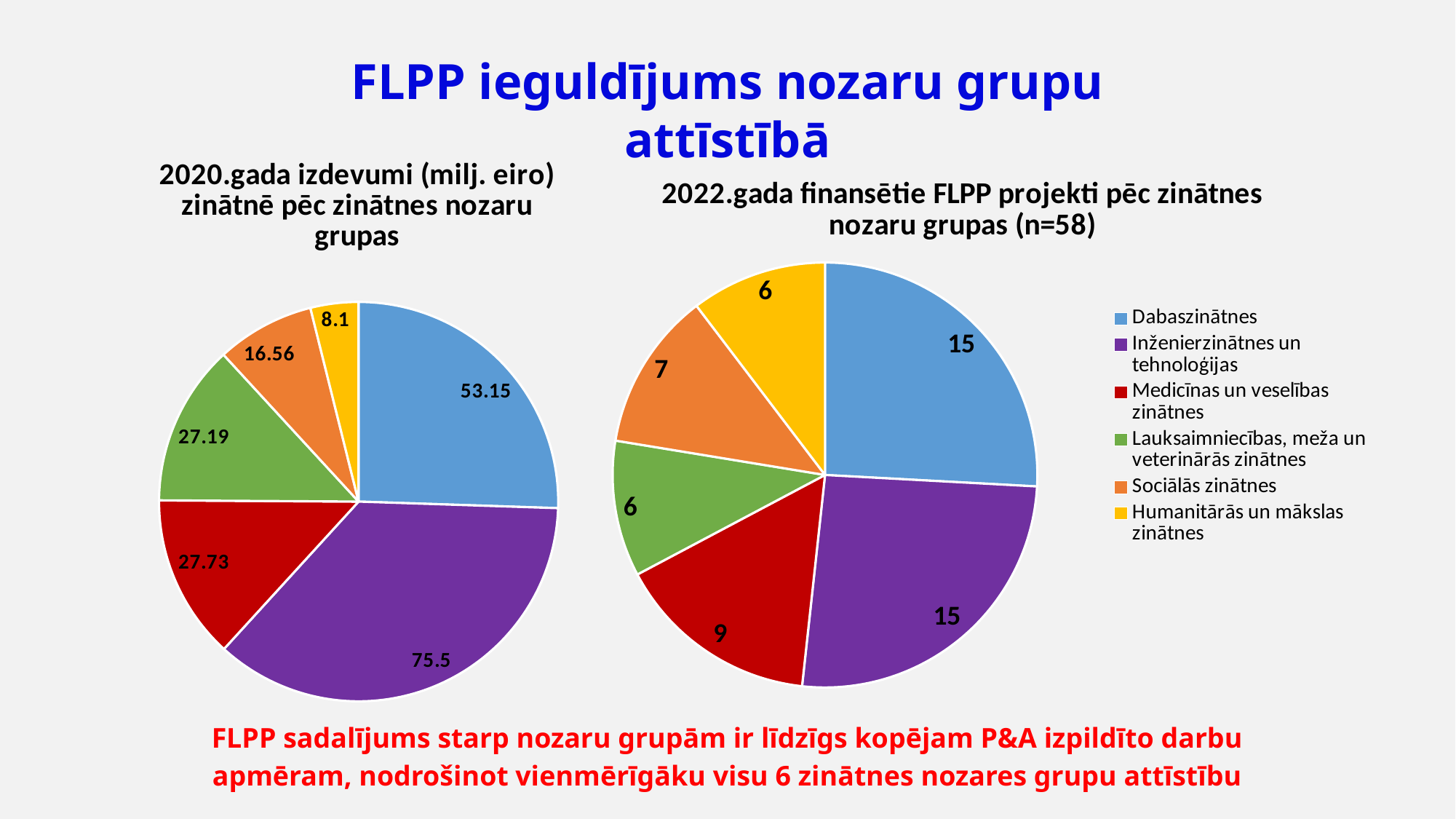
Which colour represents Humanitārās un mākslas zinātnes in the legend? Yellow In the right chart (2022.gada finansētie FLPP projekti), what is the difference between Dabaszinātnes and Medicīnas un veselības zinātnes? 6 In the left chart (2020.gada izdevumi), what is the value for Inženierzinātnes un tehnoloģijas? 75.5 In the right chart (2022.gada finansētie FLPP projekti), how many projects are in Medicīnas un veselības zinātnes? 9 In the left chart (2020.gada izdevumi), which sector group has the smallest slice? Humanitārās un mākslas zinātnes In the left chart (2020.gada izdevumi), what is the difference between Inženierzinātnes un tehnoloģijas and Dabaszinātnes? 22.35 In the left chart (2020.gada izdevumi), what is the value for Sociālās zinātnes? 16.56 What type of chart is the right chart (2022.gada finansētie FLPP projekti)? Pie chart In the right chart (2022.gada finansētie FLPP projekti), which is larger: Medicīnas un veselības zinātnes or Sociālās zinātnes? Medicīnas un veselības zinātnes In the left chart (2020.gada izdevumi), which sector group has the largest slice? Inženierzinātnes un tehnoloģijas How many sector groups are shown in the left chart (2020.gada izdevumi)? 6 In the right chart (2022.gada finansētie FLPP projekti), what is the value for Sociālās zinātnes? 7